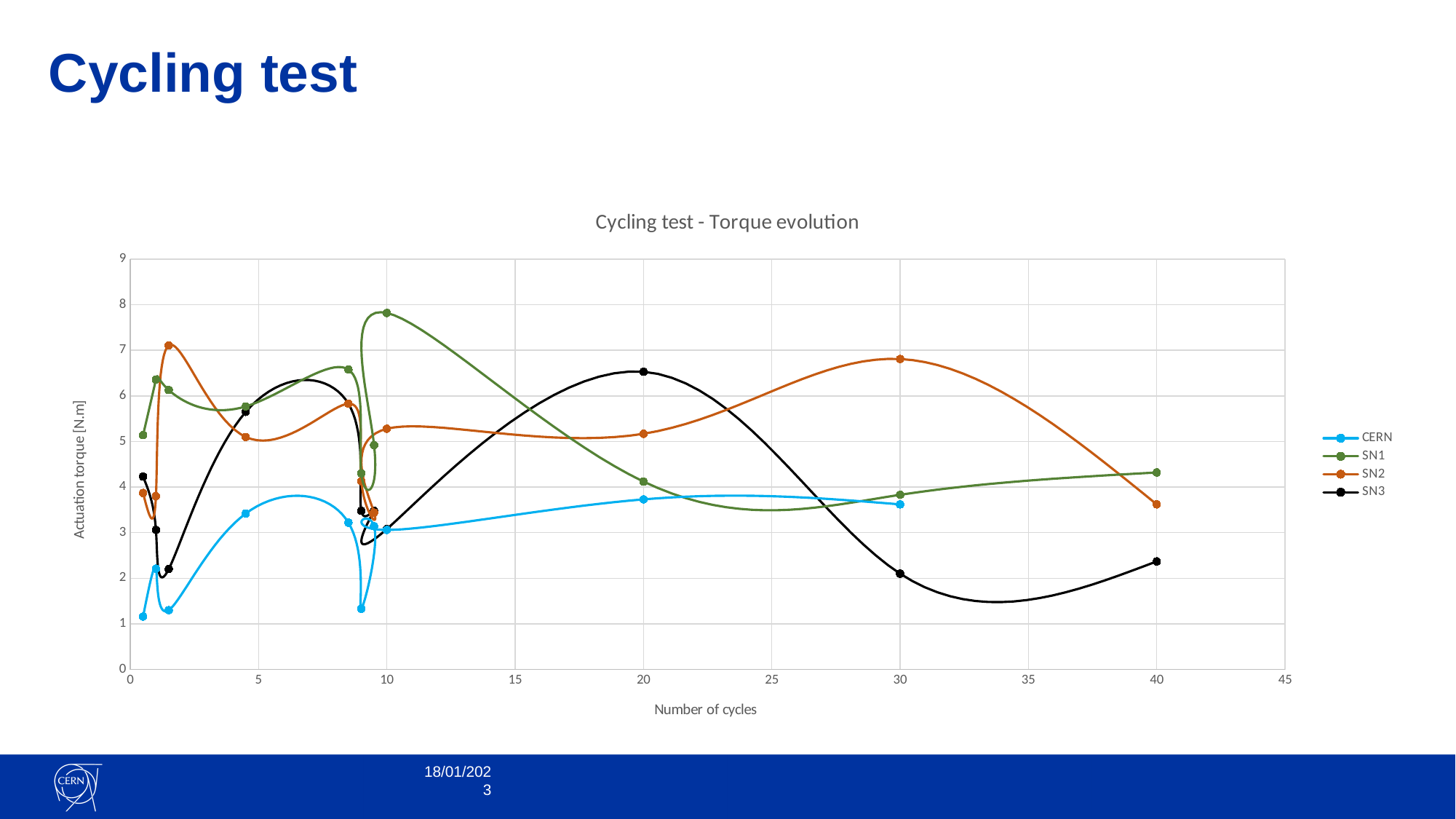
What is the label of the vertical axis? Actuation torque [N.m] At 40 cycles, which series has the higher value, SN1 or SN3? SN1 Is the value for SN3 at 30 cycles greater or less than 3? less Is the value for SN1 at 10 cycles greater or less than 7? greater At 30 cycles, which series has the higher value, SN2 or SN3? SN2 What is the title of the chart? Cycling test - Torque evolution Which series has the highest value at 20 cycles? SN3 How many series does the legend list? 4 Is the value for CERN at 20 cycles greater or less than 4? less What kind of chart is shown on the slide? line chart Does the SN3 series rise or fall between 20 and 30 cycles? fall